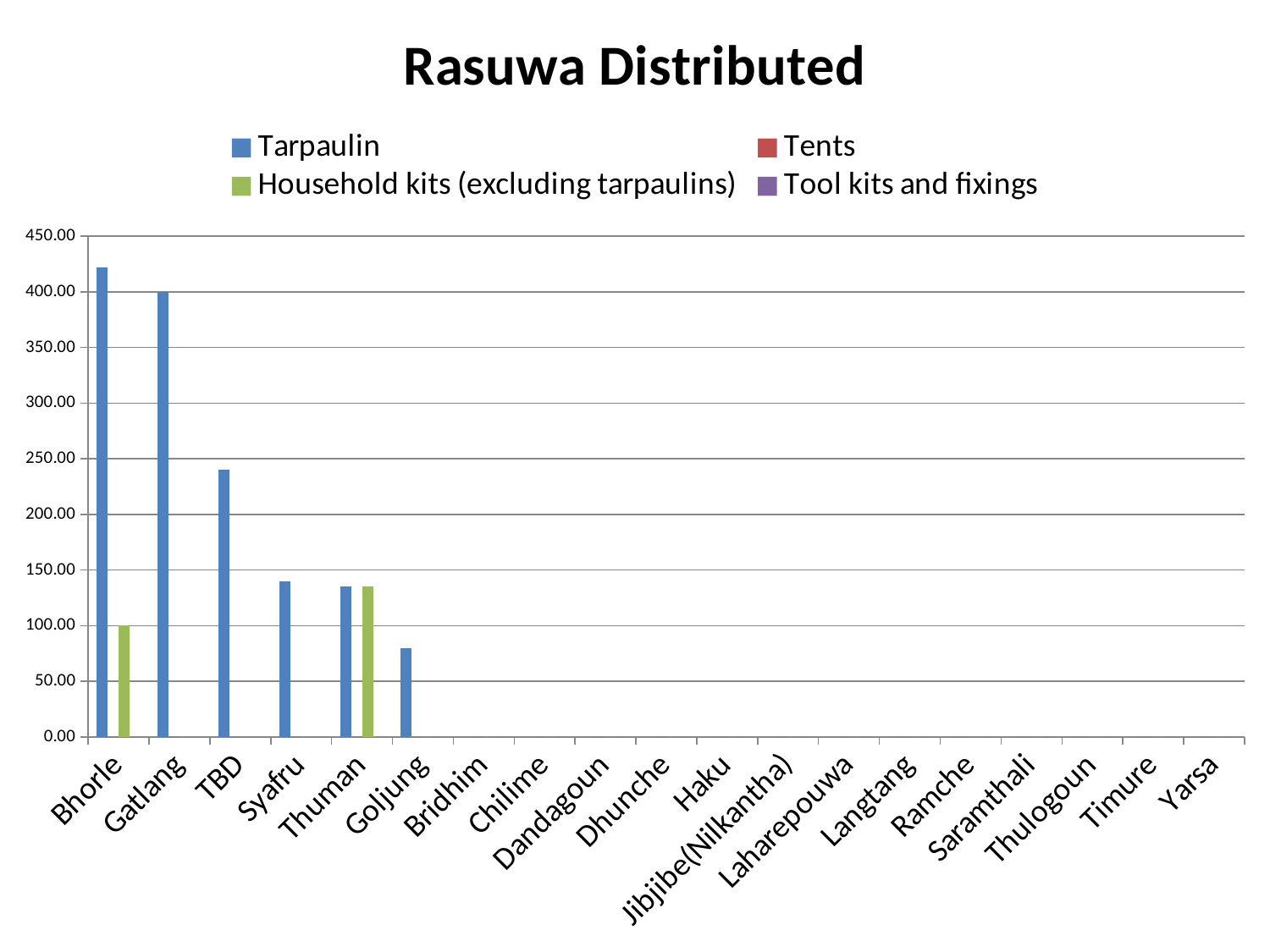
Is the Tarpaulin value for TBD greater or less than 250? less How many categories are shown on the x axis? 19 Is the Tarpaulin value for Goljung greater or less than 100? less Which colour represents the Household kits (excluding tarpaulins) series? green Is the Tarpaulin value for Syafru greater or less than 100? greater Which is larger, the Household kits (excluding tarpaulins) value for Thuman or for Bhorle? Thuman What type of chart is shown on the slide? bar chart What is the title of the chart? Rasuwa Distributed How many series does the legend list? 4 Which is larger, the Tarpaulin value for Gatlang or for TBD? Gatlang Which category has the highest Tarpaulin value? Bhorle